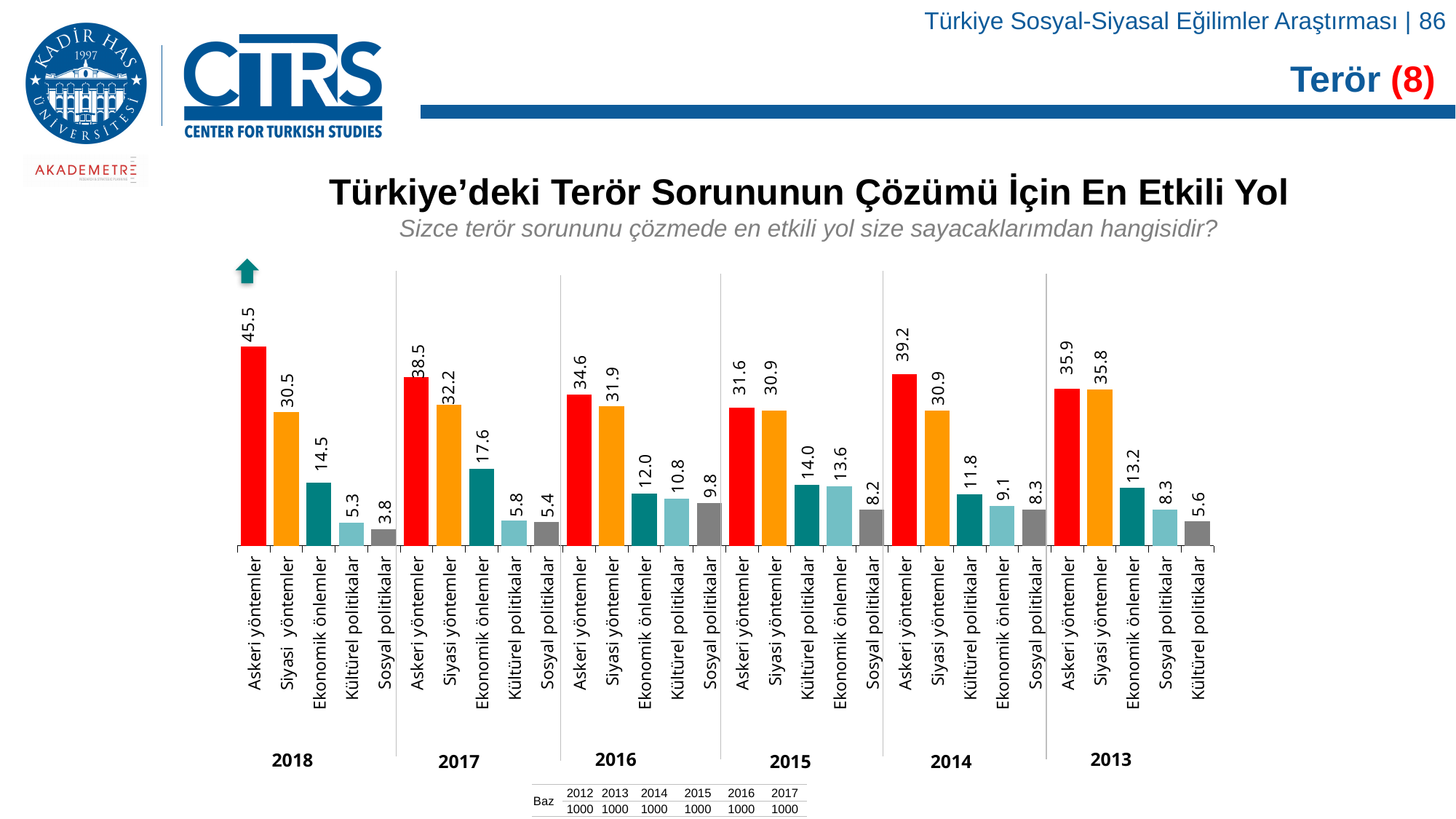
What is the value for Askeri yöntemler in 2018? 45.5 What is the difference between Askeri yöntemler and Siyasi yöntemler in 2018? 15.0 Which category has the lowest value in 2013? Kültürel politikalar Which is larger in 2015: Kültürel politikalar or Ekonomik önlemler? Kültürel politikalar How many categories are shown for each year? 5 What kind of chart is shown on the slide? Bar chart What is the value for Sosyal politikalar in 2016? 9.8 Which category has the highest value in 2018? Askeri yöntemler What is the value for Siyasi yöntemler in 2013? 35.8 How many years are shown in the chart? 6 What is the value for Kültürel politikalar in 2014? 11.8 What is the value for Ekonomik önlemler in 2017? 17.6